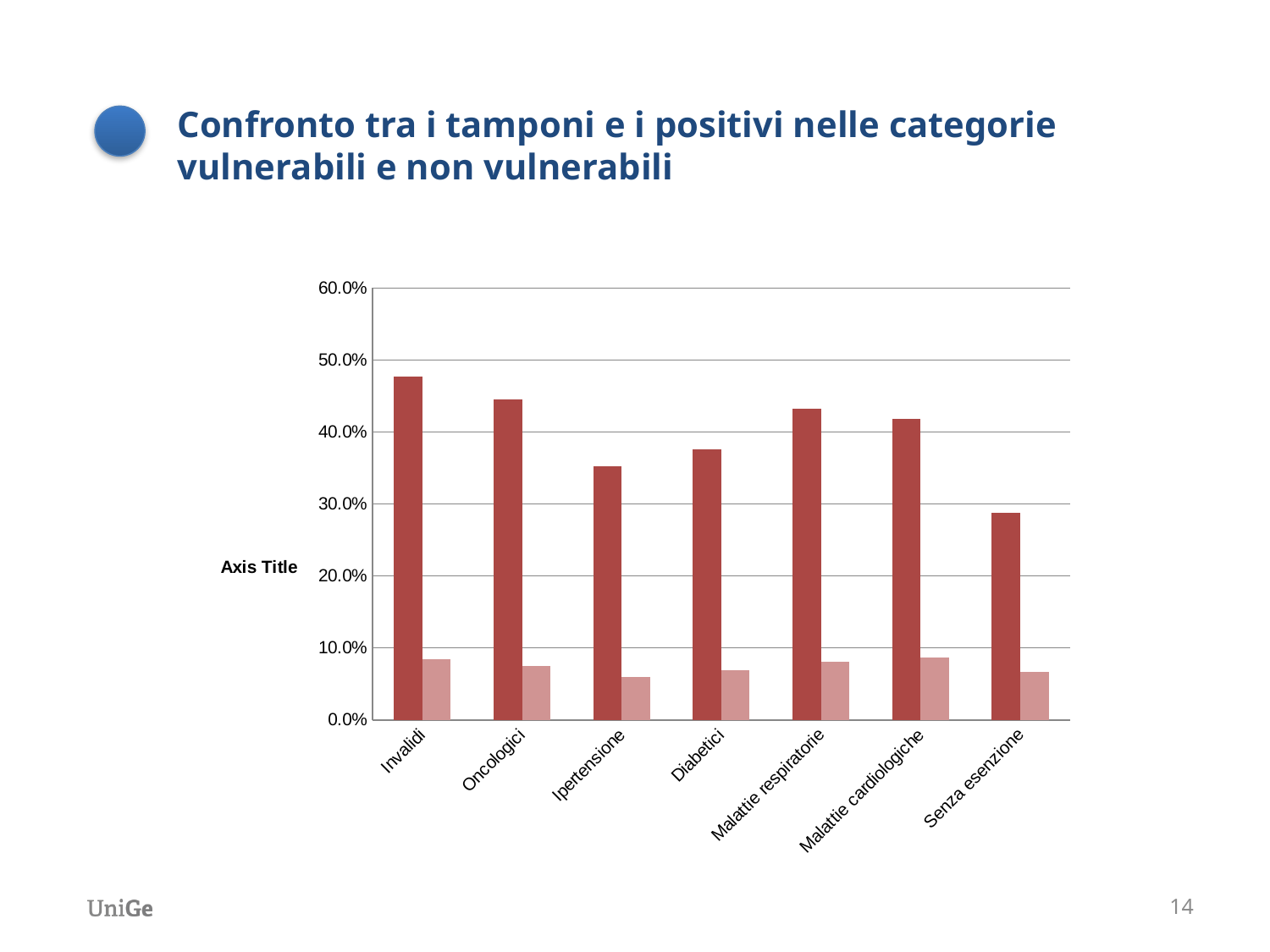
Which category has the shortest dark red bar? Senza esenzione Is the dark red bar for Malattie respiratorie greater or less than 40.0%? greater Is the dark red bar for Ipertensione greater or less than 40.0%? less Is the dark red bar for Invalidi greater or less than 40.0%? greater Which has the taller dark red bar, Oncologici or Diabetici? Oncologici What kind of chart is shown on the slide? Bar chart How many bars are plotted for each category in the chart? 2 How many categories are shown on the horizontal axis of the chart? 7 Which category has the tallest dark red bar? Invalidi What is the title of the vertical axis of the chart? Axis Title